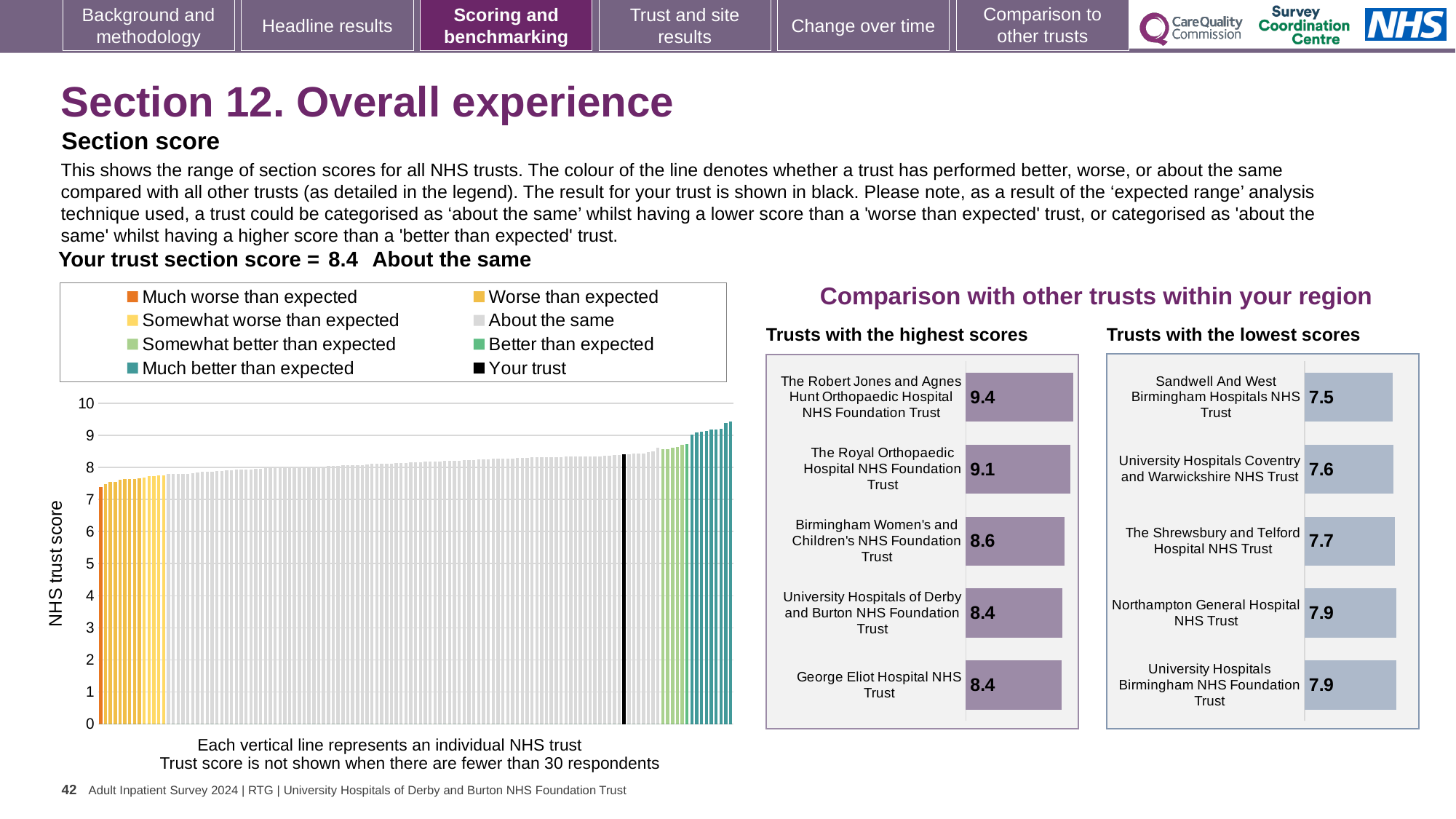
In the 'Trusts with the lowest scores' chart, which trust has the lowest score? Sandwell And West Birmingham Hospitals NHS Trust How many trusts are listed in the 'Trusts with the lowest scores' chart? 5 In the 'Trusts with the lowest scores' chart, what is the difference between the scores of Northampton General Hospital NHS Trust and Sandwell And West Birmingham Hospitals NHS Trust? 0.4 In the 'Trusts with the highest scores' chart, what is the score for Birmingham Women's and Children's NHS Foundation Trust? 8.6 In the 'Trusts with the lowest scores' chart, what is the score for The Shrewsbury and Telford Hospital NHS Trust? 7.7 In the NHS trust score chart on the left, is the value of the black 'Your trust' bar greater or less than 8? greater How many entries does the legend of the NHS trust score chart on the left list? 8 In the 'Trusts with the highest scores' chart, what is the difference between the scores of The Robert Jones and Agnes Hunt Orthopaedic Hospital NHS Foundation Trust and Birmingham Women's and Children's NHS Foundation Trust? 0.8 In the NHS trust score chart on the left, do the bar heights rise or fall from left to right? Rise In the 'Trusts with the highest scores' chart, what is the score for The Robert Jones and Agnes Hunt Orthopaedic Hospital NHS Foundation Trust? 9.4 In the 'Trusts with the highest scores' chart, which has the higher score: The Royal Orthopaedic Hospital NHS Foundation Trust or George Eliot Hospital NHS Trust? The Royal Orthopaedic Hospital NHS Foundation Trust What kind of chart is the NHS trust score chart on the left of the slide? Bar chart